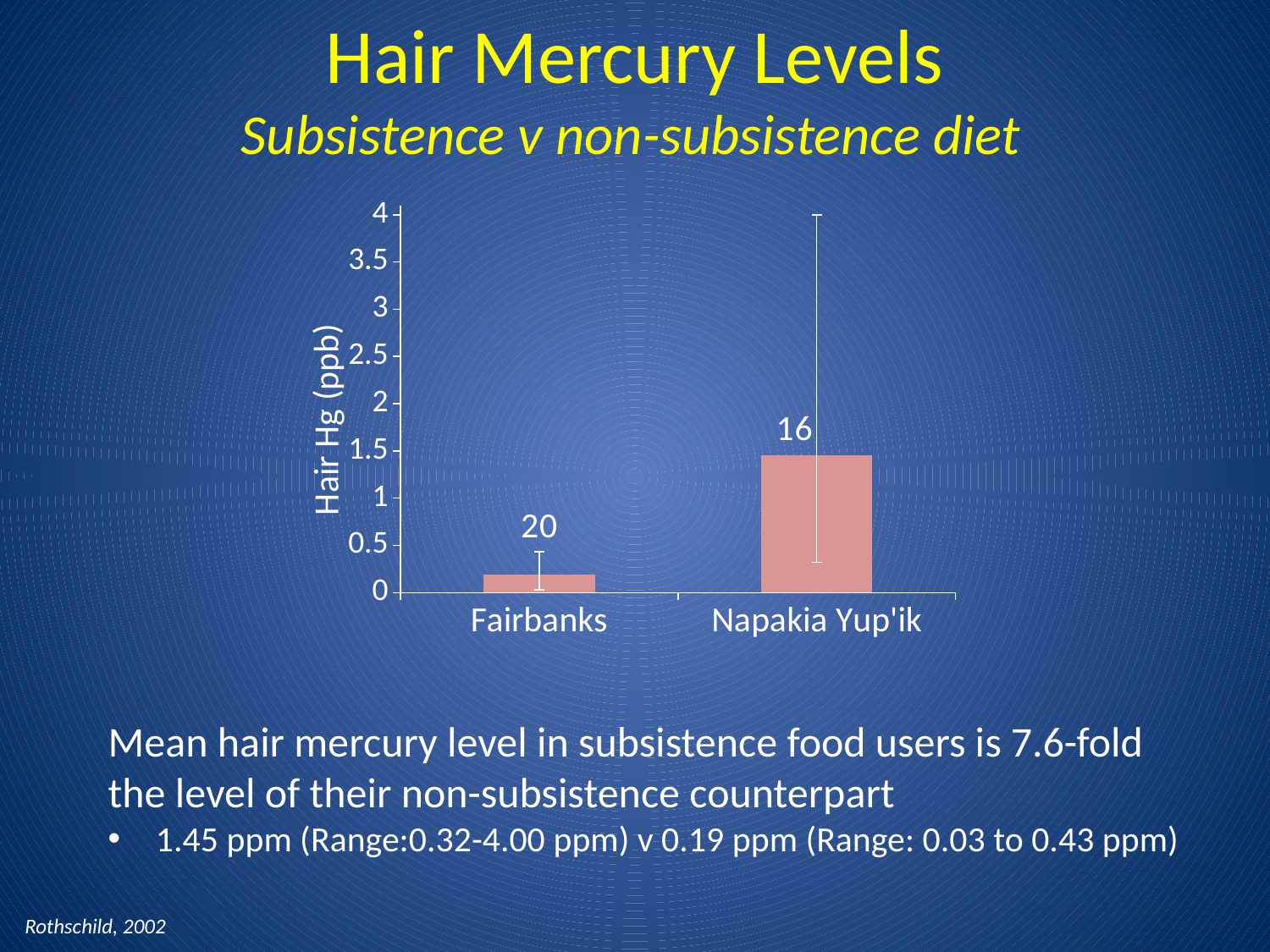
Is the value for Fairbanks greater or less than 1? less Is the value for Fairbanks greater or less than 0.5? less What number is printed above the Fairbanks bar? 20 What kind of chart is shown on the slide? bar chart Is the value for Napakia Yup'ik greater or less than 1? greater Which bar is taller, Fairbanks or Napakia Yup'ik? Napakia Yup'ik Which category has the highest hair mercury level in the chart? Napakia Yup'ik How many categories are plotted on the x axis of the chart? 2 What is the label on the vertical axis of the chart? Hair Hg (ppb) Which category has the lowest hair mercury level in the chart? Fairbanks Do the bar values rise or fall moving from left to right along the x axis? rise